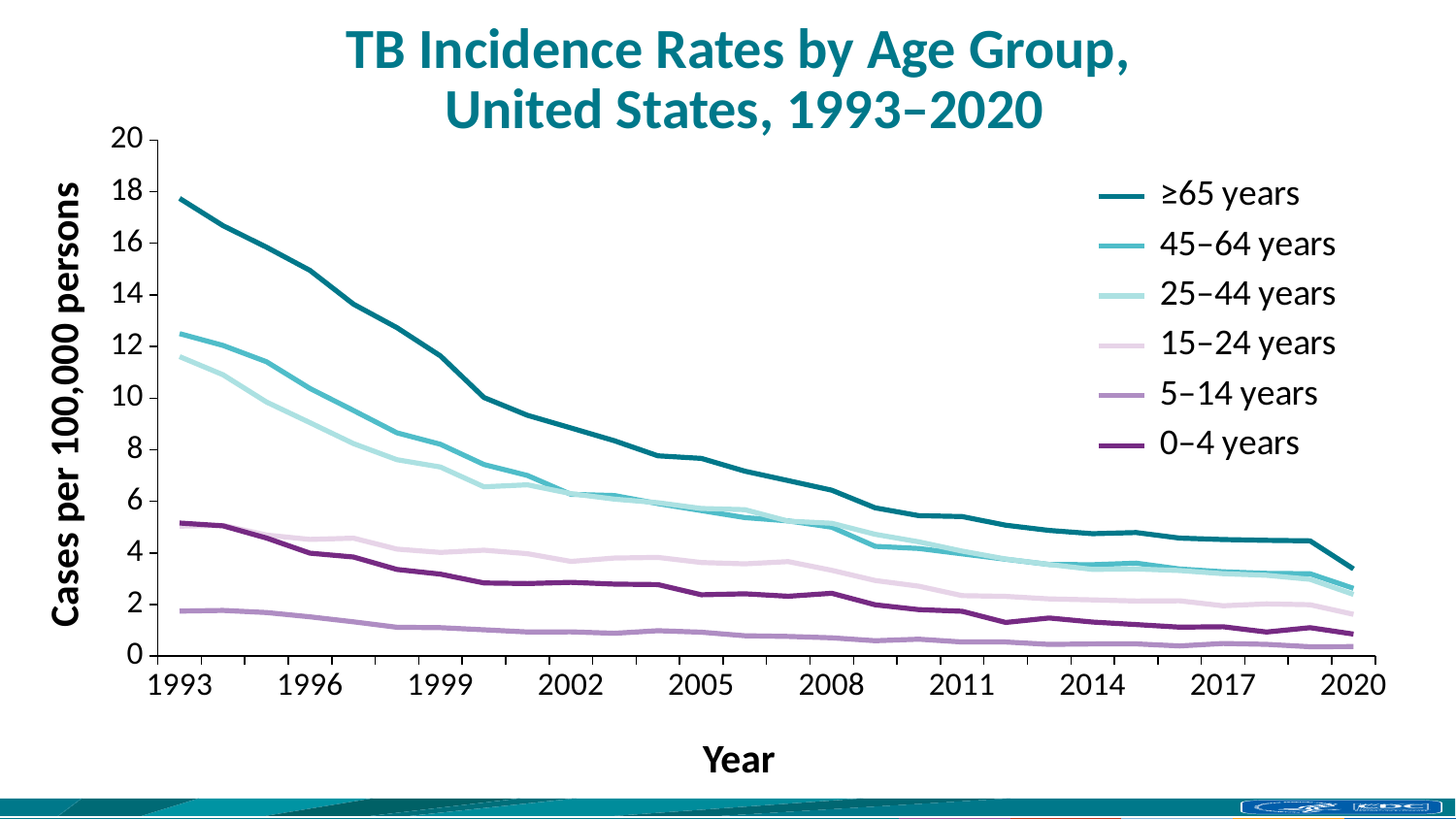
How many age groups does the legend list? 6 What is the label on the y axis of the chart? Cases per 100,000 persons In 1993, which has the higher TB incidence rate: the 0–4 years group or the 5–14 years group? 0–4 years Is the 1993 value for the 45–64 years group greater or less than 10? greater Is the 2020 value for the ≥65 years group greater or less than 6? less Which age group has the highest TB incidence rate in 1993? ≥65 years Which age group has the lowest TB incidence rate in 1993? 5–14 years What kind of chart is shown on the slide? line chart Is the 1993 value for the ≥65 years group greater or less than 16? greater Does the TB incidence rate for the ≥65 years group rise or fall from 1993 to 2020? fall In 1999, which has the higher TB incidence rate: the ≥65 years group or the 45–64 years group? ≥65 years